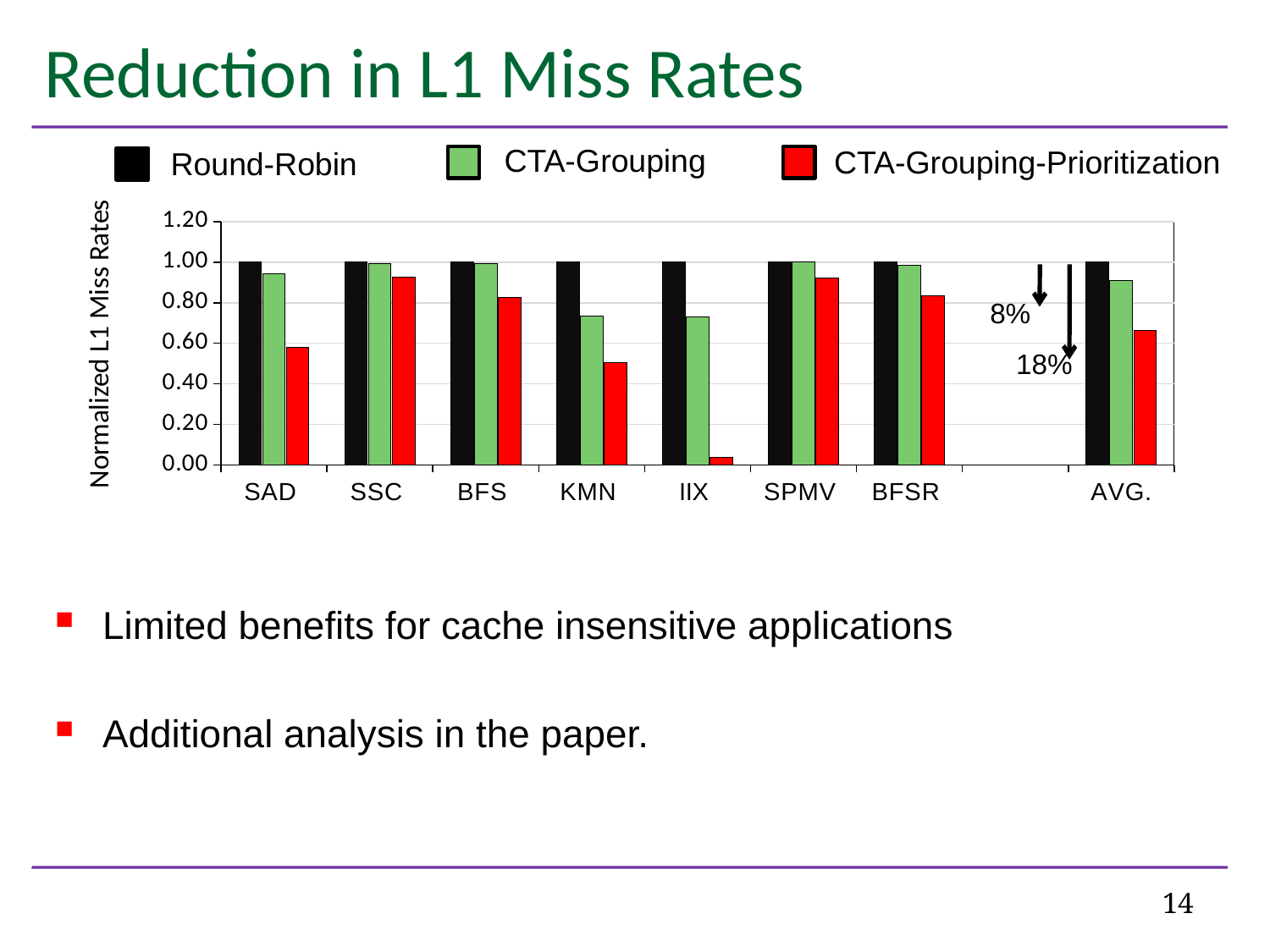
Which is larger, the CTA-Grouping value for KMN or for SSC? SSC Which category has the lowest CTA-Grouping-Prioritization value? IIX What is the label of the y axis? Normalized L1 Miss Rates What kind of chart is shown on the slide? bar chart Is the CTA-Grouping-Prioritization value for IIX greater or less than 0.20? less Is the CTA-Grouping value for KMN greater or less than 0.60? greater How many series does the legend list? 3 Is the CTA-Grouping-Prioritization value for SAD greater or less than 0.80? less What is the Round-Robin value for SAD? 1.00 How many categories are shown along the x axis? 8 Which is larger, the CTA-Grouping-Prioritization value for SAD or for SSC? SSC What percentage reduction is annotated for CTA-Grouping-Prioritization at AVG.? 18%